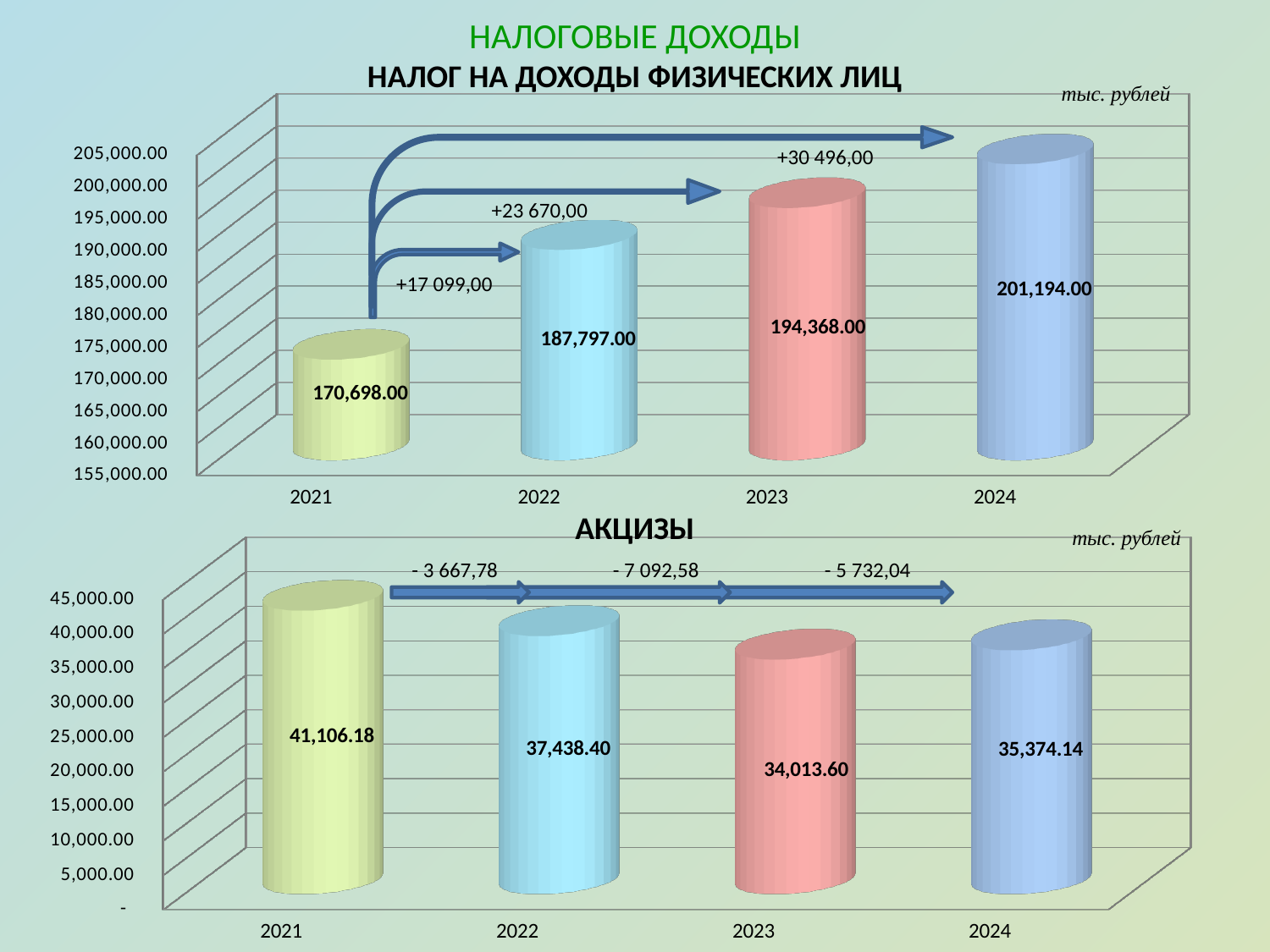
What kind of chart is the chart titled АКЦИЗЫ? bar chart In the chart titled АКЦИЗЫ, which is larger, the value for 2023 or the value for 2024? 2024 In the chart titled НАЛОГ НА ДОХОДЫ ФИЗИЧЕСКИХ ЛИЦ, do the values rise or fall from 2021 to 2024? rise In the chart titled НАЛОГ НА ДОХОДЫ ФИЗИЧЕСКИХ ЛИЦ, which year has the highest value? 2024 In the chart titled АКЦИЗЫ, what is the difference between the 2021 value and the 2022 value? 3,667.78 In the chart titled АКЦИЗЫ, which year has the lowest value? 2023 In the chart titled АКЦИЗЫ, what is the value for 2023? 34,013.60 In the chart titled НАЛОГ НА ДОХОДЫ ФИЗИЧЕСКИХ ЛИЦ, what is the difference between the 2024 value and the 2021 value? 30,496.00 In the chart titled НАЛОГ НА ДОХОДЫ ФИЗИЧЕСКИХ ЛИЦ, how many years are plotted? 4 In the chart titled НАЛОГ НА ДОХОДЫ ФИЗИЧЕСКИХ ЛИЦ, which year has the lowest value? 2021 In the chart titled НАЛОГ НА ДОХОДЫ ФИЗИЧЕСКИХ ЛИЦ, what is the value for 2022? 187,797.00 In the chart titled АКЦИЗЫ, which year has the highest value? 2021